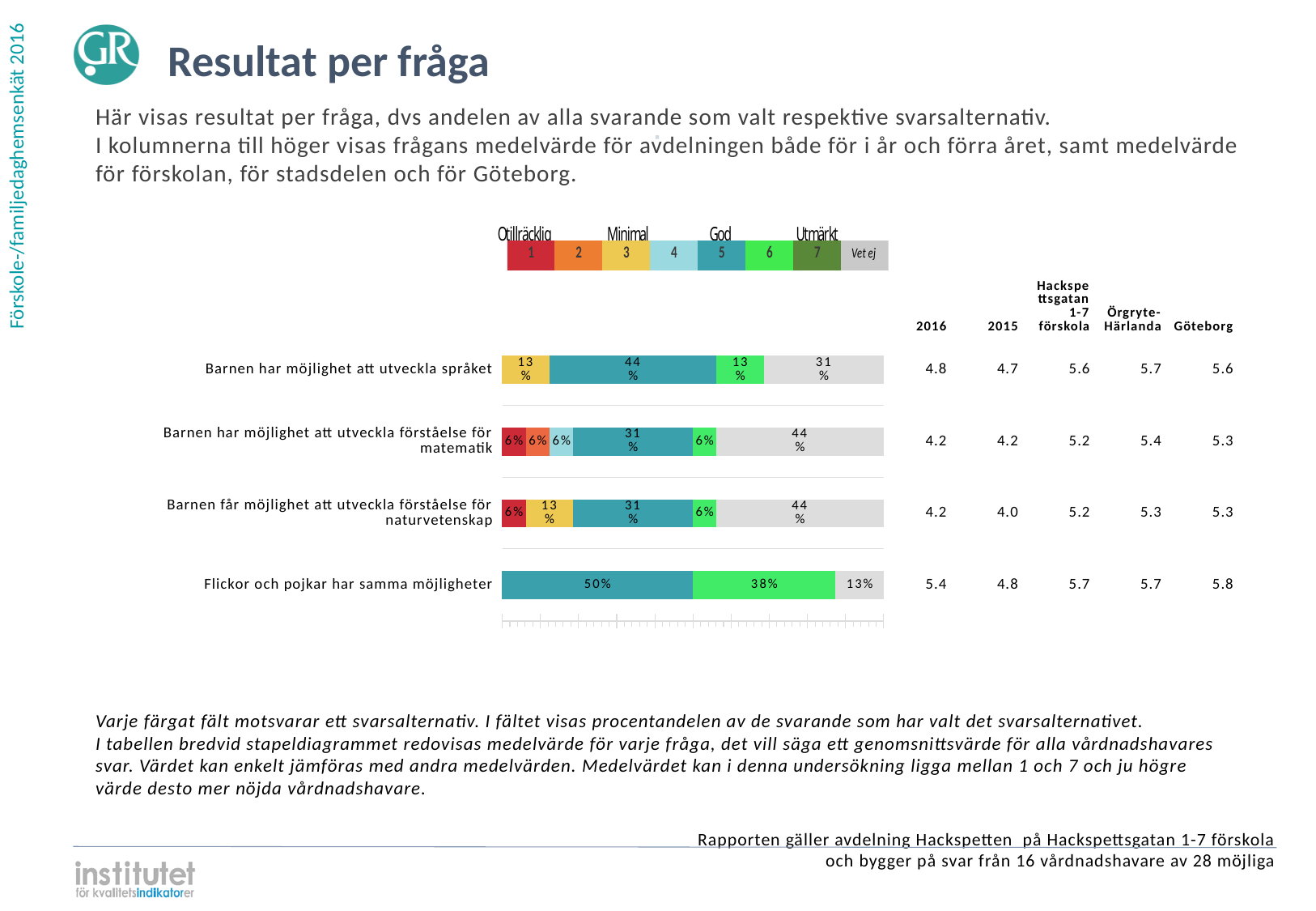
What kind of chart is shown on the slide? Stacked bar chart What percentage of respondents chose option 1 (red) for 'Barnen har möjlighet att utveckla förståelse för matematik'? 6% How many response options does the legend above the chart list, including 'Vet ej'? 8 Which question has the largest 'Vet ej' share? Barnen har möjlighet att utveckla förståelse för matematik and Barnen får möjlighet att utveckla förståelse för naturvetenskap (44% each) What label does the legend give to response option 7? Utmärkt What percentage of respondents chose 'Vet ej' for 'Barnen har möjlighet att utveckla språket'? 31% What percentage of respondents chose option 6 (green) for 'Flickor och pojkar har samma möjligheter'? 38% What is the difference between the option 5 (teal) share for 'Flickor och pojkar har samma möjligheter' and for 'Barnen har möjlighet att utveckla språket'? 6 percentage points How many questions (categories) are plotted in the bar chart? 4 Which is larger: the option 6 (green) share for 'Flickor och pojkar har samma möjligheter' or for 'Barnen har möjlighet att utveckla språket'? Flickor och pojkar har samma möjligheter Which question has the smallest 'Vet ej' share? Flickor och pojkar har samma möjligheter What percentage of respondents chose option 5 (teal) for 'Flickor och pojkar har samma möjligheter'? 50%